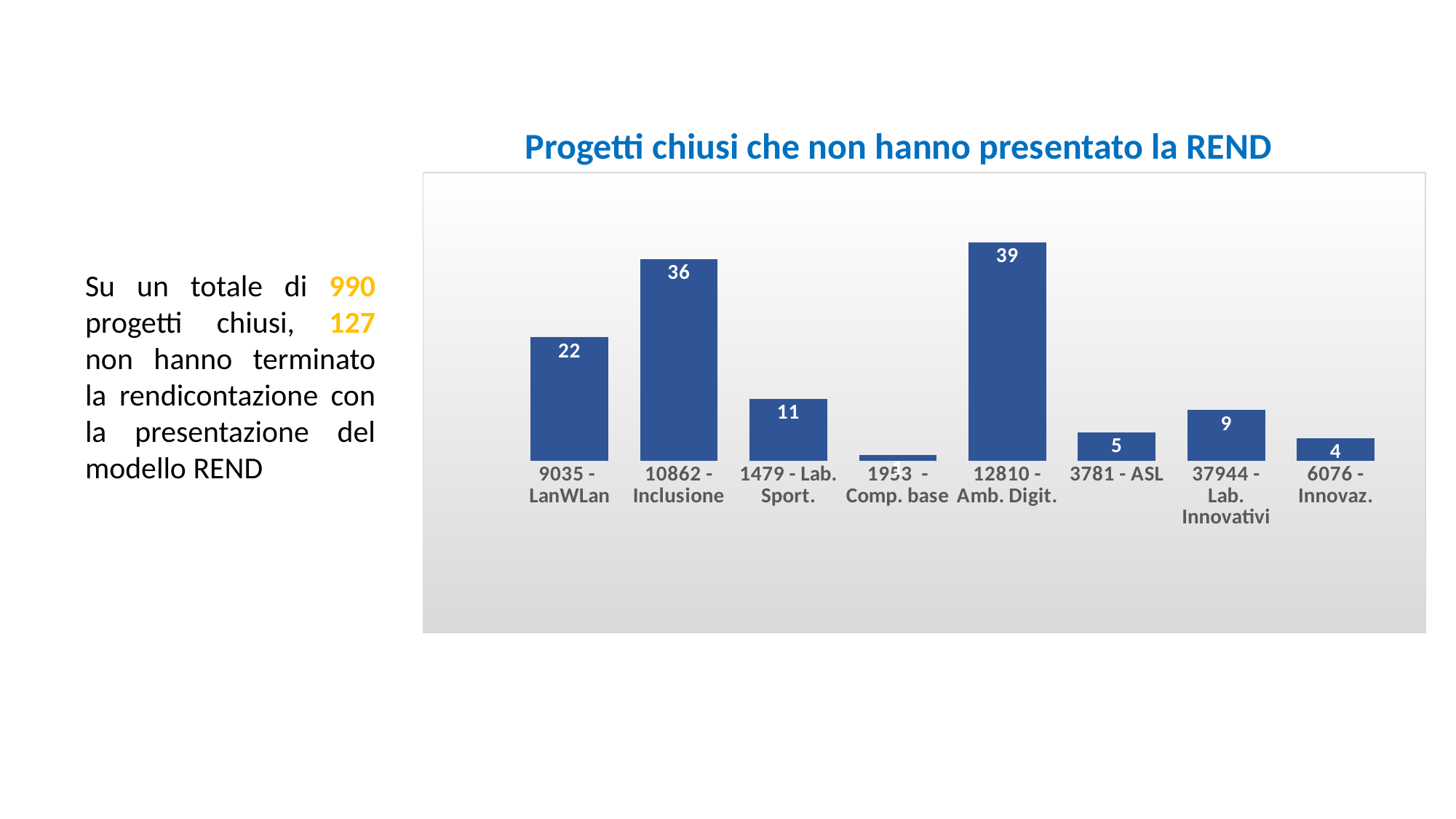
What is the difference between the values for 9035 - LanWLan and 1479 - Lab. Sport.? 11 What is the value for 10862 - Inclusione? 36 What is the value for 12810 - Amb. Digit.? 39 What is the value for 37944 - Lab. Innovativi? 9 How many categories are shown in the chart? 8 What is the difference between the values for 12810 - Amb. Digit. and 10862 - Inclusione? 3 Which category has the highest value? 12810 - Amb. Digit. What is the value for 9035 - LanWLan? 22 Which is larger, the value for 6076 - Innovaz. or the value for 3781 - ASL? 3781 - ASL What kind of chart is shown on the slide? Bar chart What is the value for 3781 - ASL? 5 Which category has the lowest value? 1953 - Comp. base